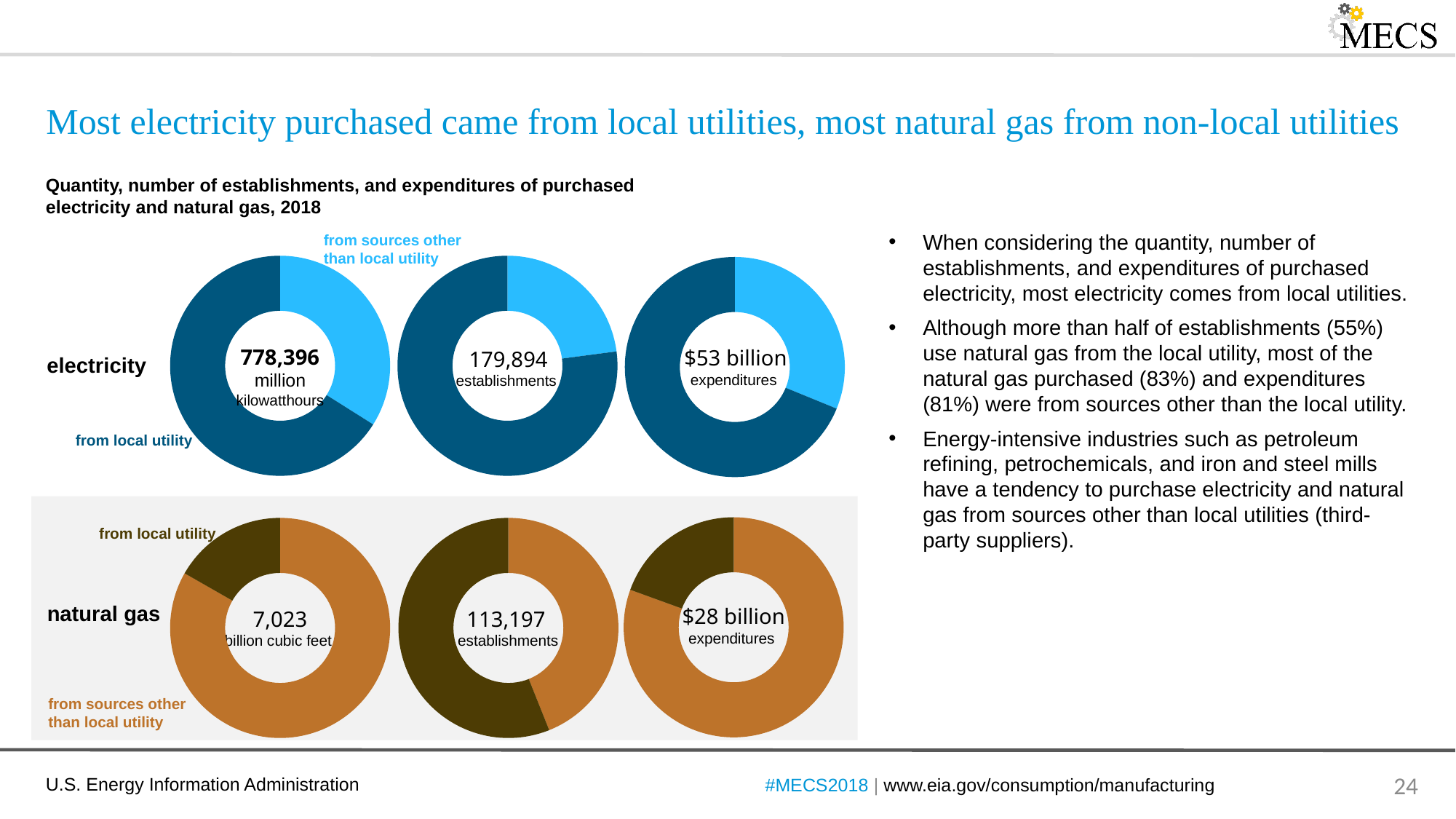
What kind of charts are shown on the slide? Donut (pie) charts In the natural gas expenditures donut chart, which slice is larger: from local utility or from sources other than local utility? from sources other than local utility In the natural gas establishments donut chart, how many establishments are shown in the center? 113,197 Comparing the electricity and natural gas establishments donut charts, which has the larger number of establishments in its center? electricity (179,894) In the natural gas quantity donut chart, what quantity is printed in the center? 7,023 billion cubic feet In the electricity quantity donut chart, what total quantity is printed in the center? 778,396 million kilowatthours In the electricity quantity donut chart, which slice is larger: from local utility or from sources other than local utility? from local utility In the natural gas expenditures donut chart, what expenditure value is printed in the center? $28 billion What colour represents 'from local utility' in the electricity donut charts? Dark blue How many donut charts are on the slide? 6 In the electricity establishments donut chart, how many establishments are shown in the center? 179,894 In the electricity expenditures donut chart, what expenditure value is printed in the center? $53 billion